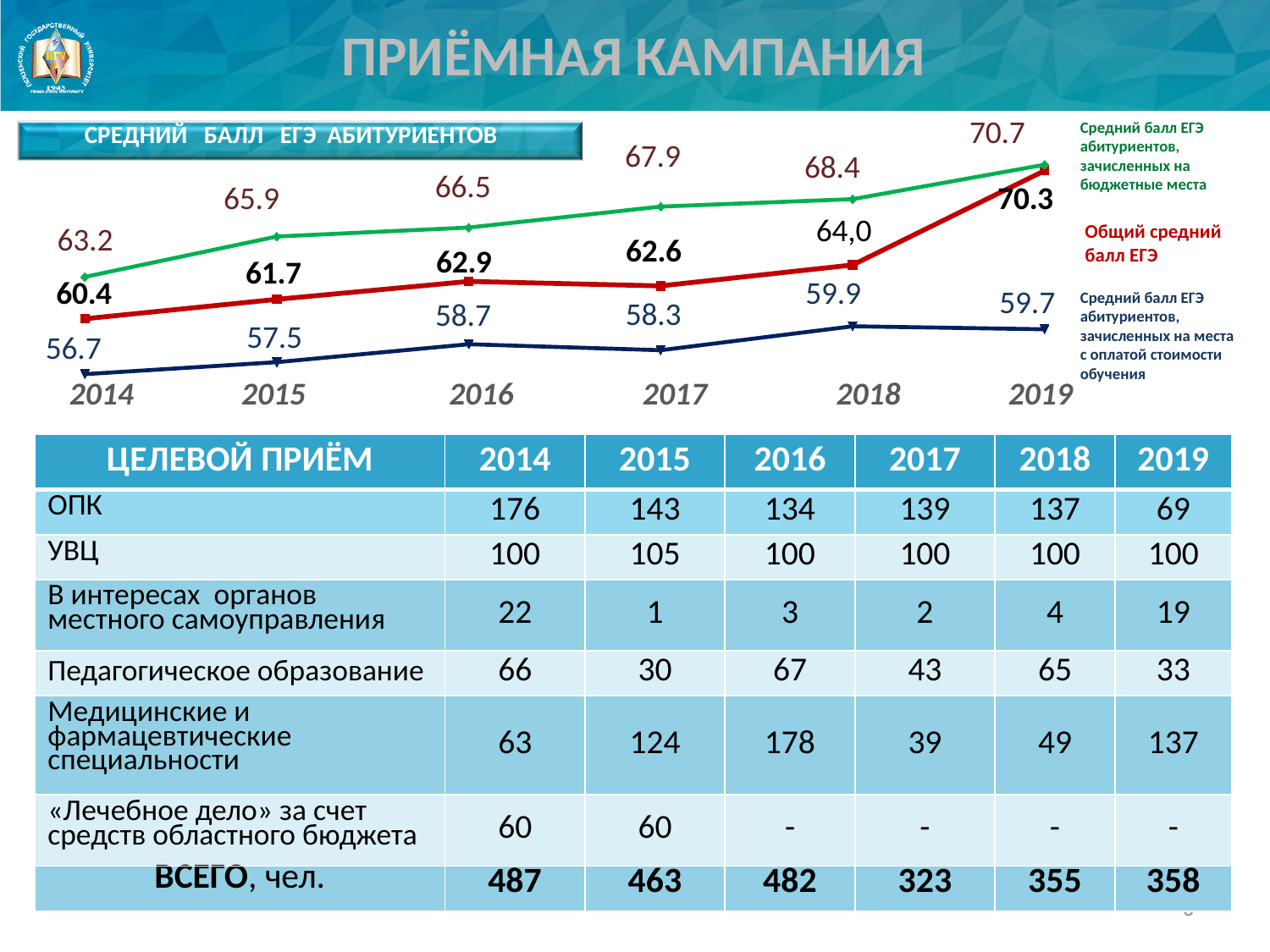
In the line chart, in which year is the average ЕГЭ score for budget places the highest? 2019 In the line chart, what is the overall average ЕГЭ score (Общий средний балл ЕГЭ) in 2016? 62.9 In the line chart, what is the difference between the budget-place average score and the paid-place average score in 2017? 9.6 How many years are plotted on the x axis of the line chart? 6 In the line chart, what is the average ЕГЭ score of applicants admitted to paid places in 2014? 56.7 In the line chart, which is higher in 2015: the overall average ЕГЭ score or the paid-place average score? the overall average ЕГЭ score (61.7) In the line chart, does the average ЕГЭ score for budget places rise or fall from 2014 to 2019? rise In the line chart, what is the overall average ЕГЭ score in 2018? 64,0 In the line chart, what is the average ЕГЭ score of applicants admitted to budget places in 2019? 70.7 In the line chart, in which year is the average ЕГЭ score for paid places the lowest? 2014 How many series does the line chart show? 3 What type of chart is shown under the heading «СРЕДНИЙ БАЛЛ ЕГЭ АБИТУРИЕНТОВ»? line chart